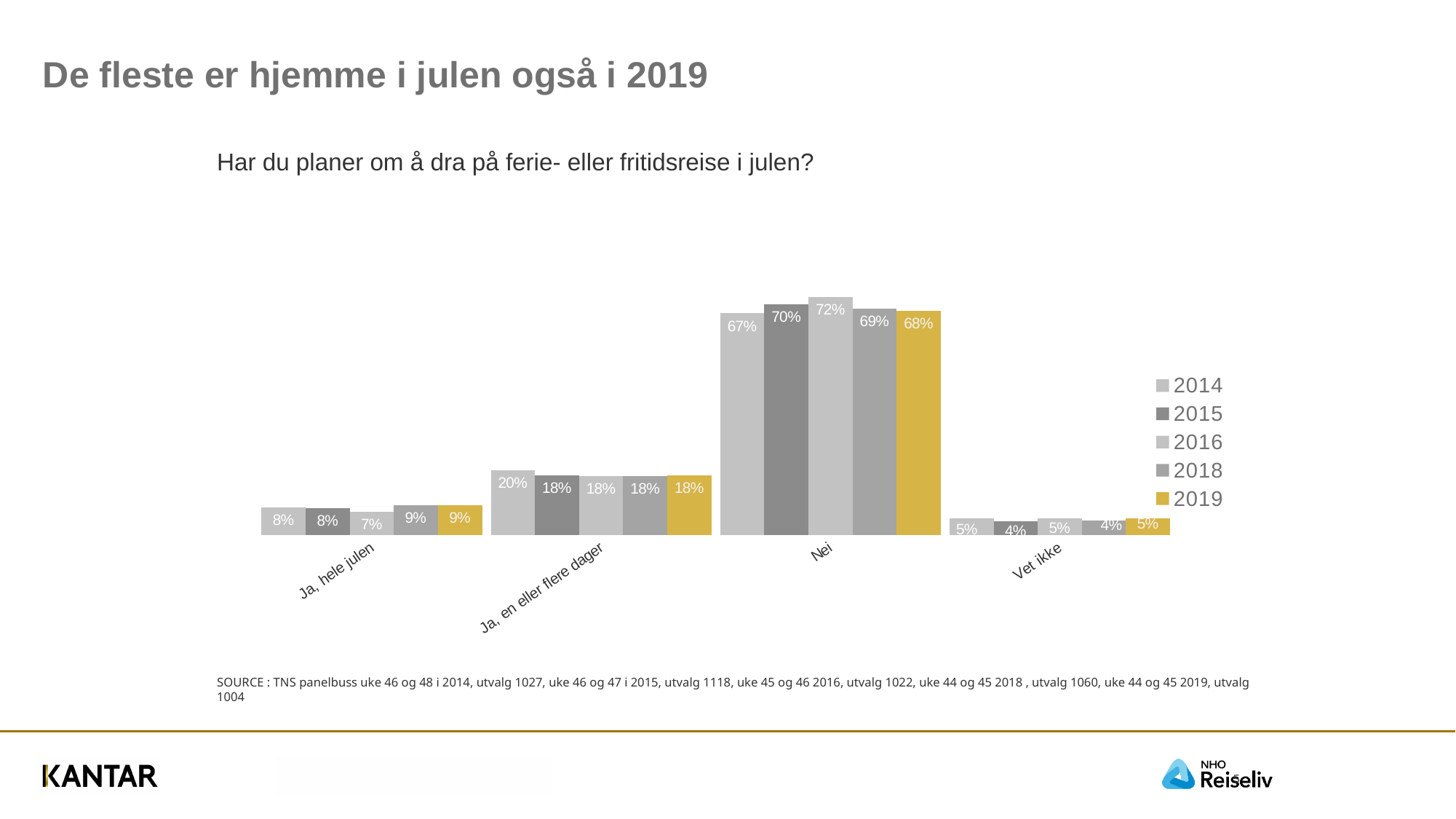
What is the value for 'Vet ikke' in 2018? 4% What is the value for 'Ja, hele julen' in 2016? 7% How many categories are shown on the x axis? 4 What is the value for 'Ja, en eller flere dager' in 2014? 20% How many series does the legend list? 5 Which category has the lowest value in 2015? Vet ikke What is the value for 'Nei' in 2019? 68% Which year has the highest value for 'Nei'? 2016 What kind of chart is shown on the slide? Bar chart Which series is shown in gold/yellow in the legend? 2019 What is the difference between the 2016 and 2019 values for 'Nei'? 4% Which is larger for 'Ja, hele julen': the 2014 value or the 2019 value? 2019